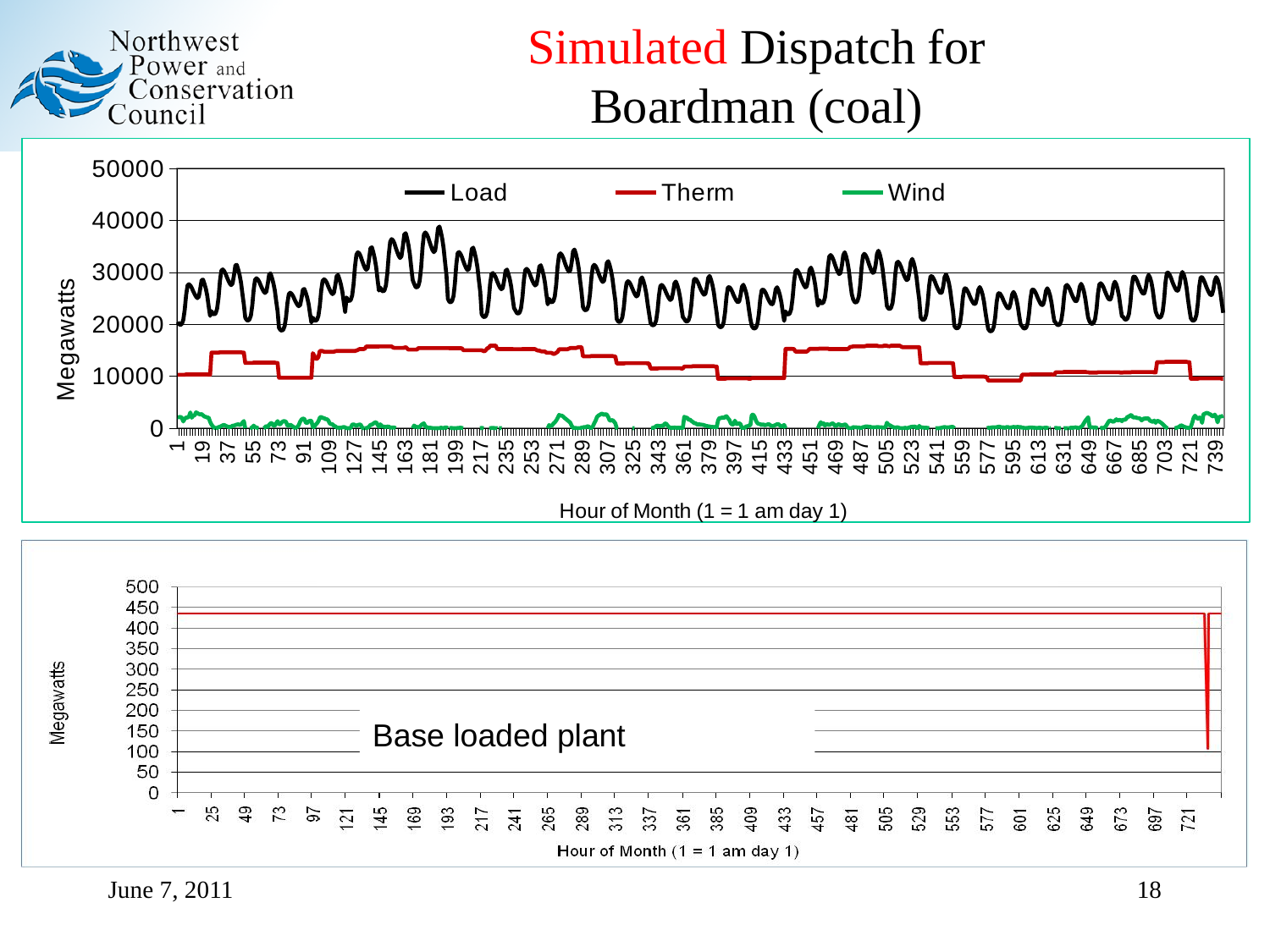
In the top chart, is the peak Load value greater or less than 40000? less In the bottom chart, is the plant output for most of the month greater or less than 400? greater In the top chart, is the Therm value at hour 1 greater or less than 20000? less What are the three series named in the legend of the top chart? Load, Therm, Wind How many series does the legend of the top chart list? 3 In the top chart, which series has the highest values throughout the month? Load What kind of chart is the top chart (Simulated Dispatch for Boardman)? Line chart What kind of chart is the bottom chart? Line chart In the top chart, at hour 1, which is larger: Load or Therm? Load In the top chart, which series has the lowest values throughout the month? Wind What text annotation is printed inside the bottom chart? Base loaded plant